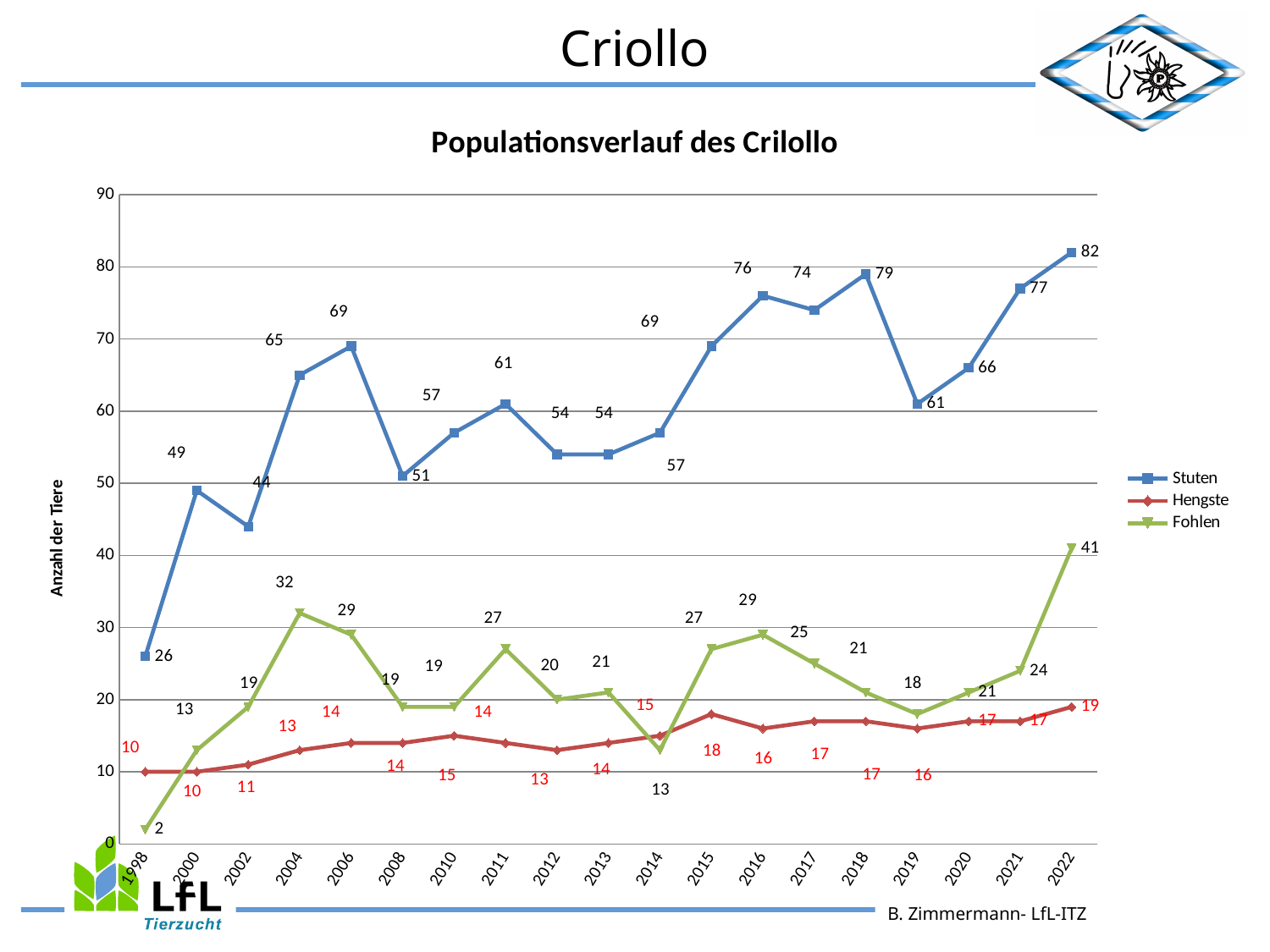
What is the value for Hengste in 2015? 18 What is the label of the y axis? Anzahl der Tiere What is the difference between the Stuten value in 2022 and in 1998? 56 In which year is the Hengste value highest? 2022 How many years are plotted along the x axis? 19 In which year is the Stuten value highest? 2022 Which is larger in 2022, the Fohlen value or the Hengste value? Fohlen What kind of chart is shown on the slide? line chart How many series does the legend list? 3 What is the value for Stuten in 2022? 82 In which year is the Fohlen value lowest? 1998 What is the value for Fohlen in 2004? 32